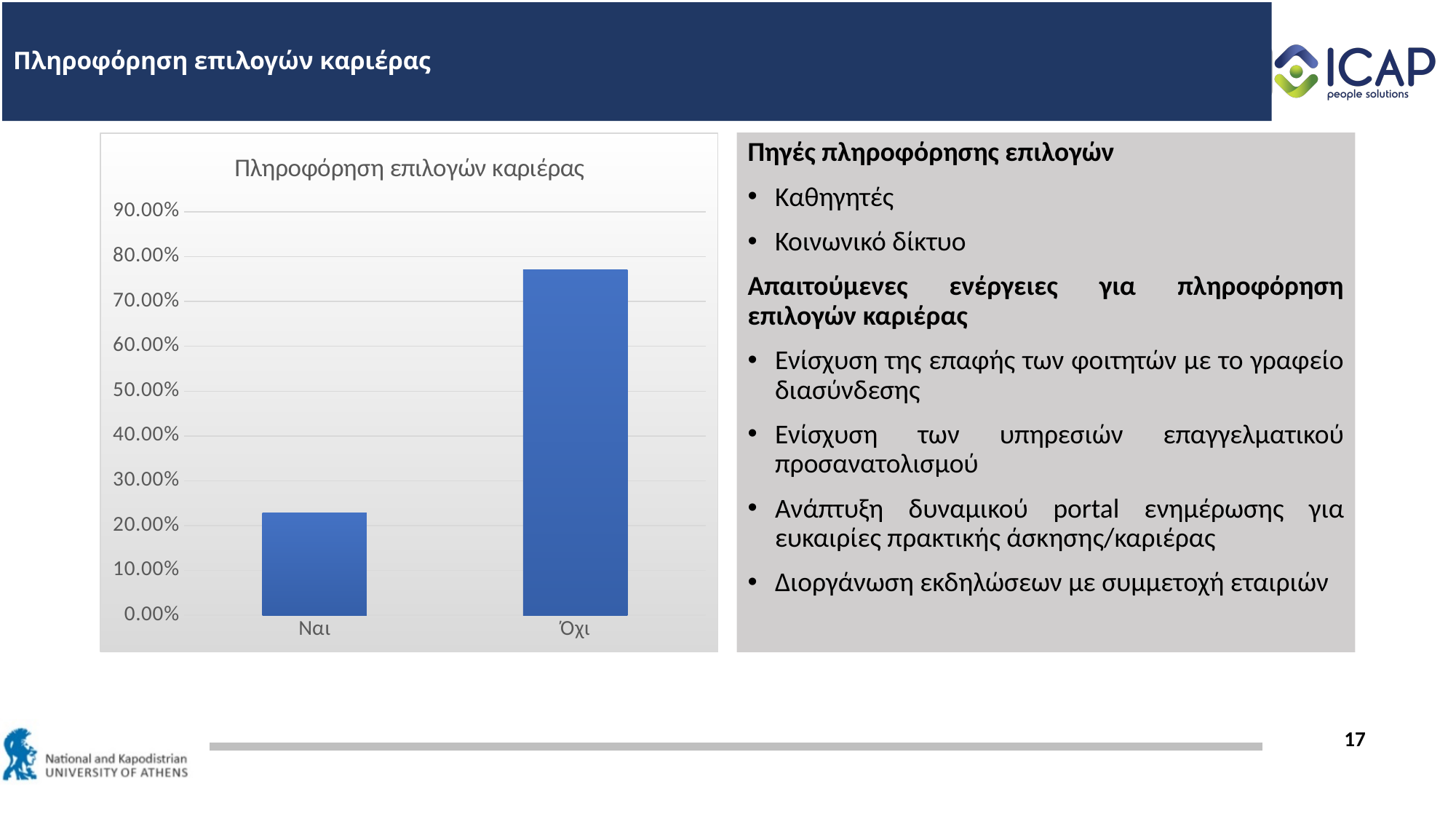
Is the value for Ναι greater or less than 30.00%? less Which is larger, the value for Ναι or the value for Όχι? Όχι Is the value for Ναι greater or less than 20.00%? greater Is the value for Όχι greater or less than 70.00%? greater Which category has the lowest value in the chart? Ναι Which category has the highest value in the chart? Όχι How many categories are shown on the x axis of the chart? 2 What type of chart is shown on the slide? Bar chart What is the highest value shown on the y axis of the chart? 90.00% What is the title of the chart? Πληροφόρηση επιλογών καριέρας